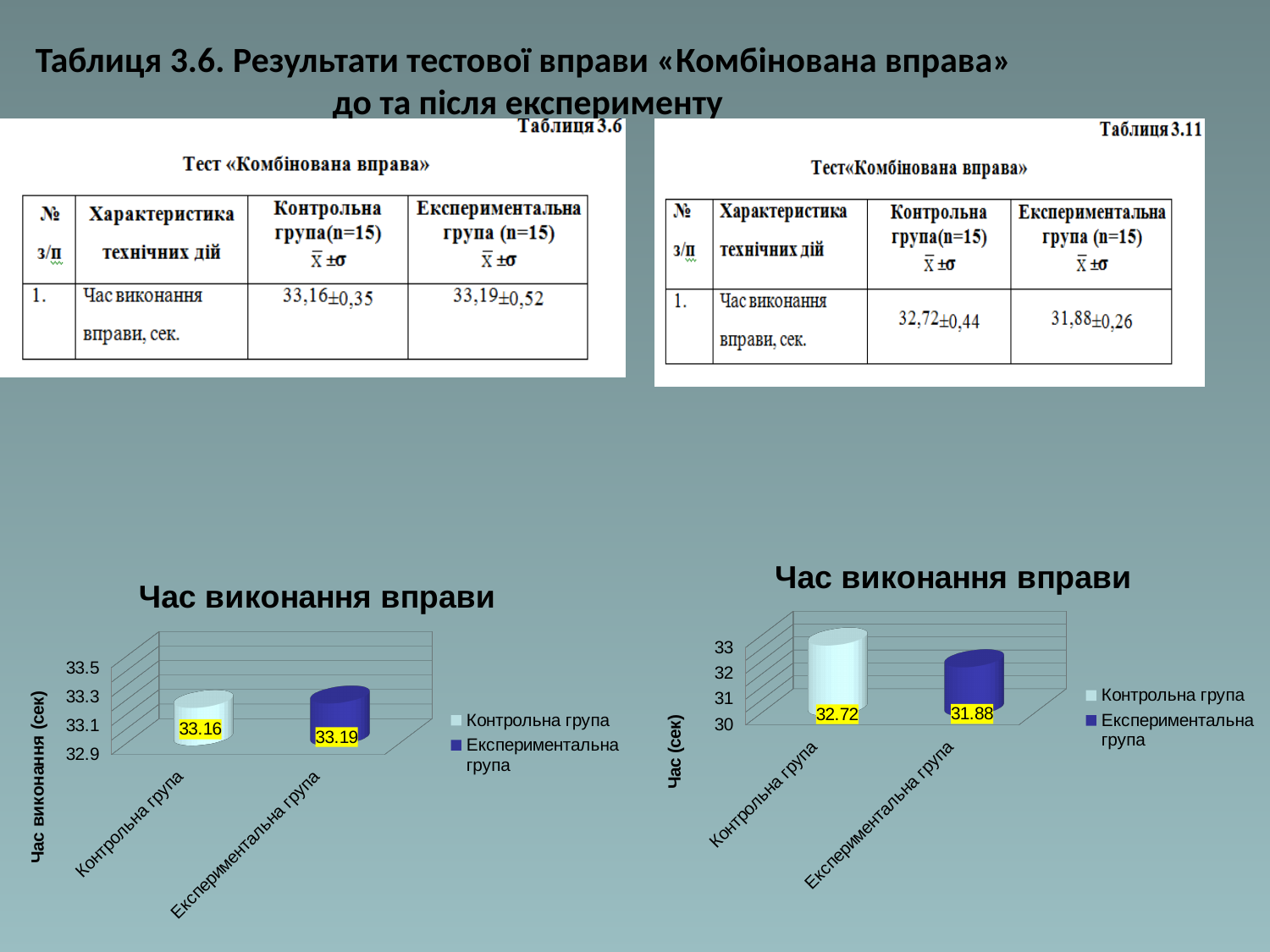
In the right chart, what is the value for Експериментальна група? 31.88 In the left chart, what is the value for Експериментальна група? 33.19 In the right chart, what is the difference between the values for Контрольна група and Експериментальна група? 0.84 In the left chart, what is the value for Контрольна група? 33.16 What kind of chart is the right chart? bar chart What is the title of the left chart? Час виконання вправи How many series does the legend of the left chart list? 2 In the right chart, what is the value for Контрольна група? 32.72 In the left chart, what is the difference between the values for Експериментальна група and Контрольна група? 0.03 In the right chart, is the value for Контрольна група greater or less than 32? greater In the right chart, which group has the lowest value? Експериментальна група In the right chart, which group has the highest value? Контрольна група